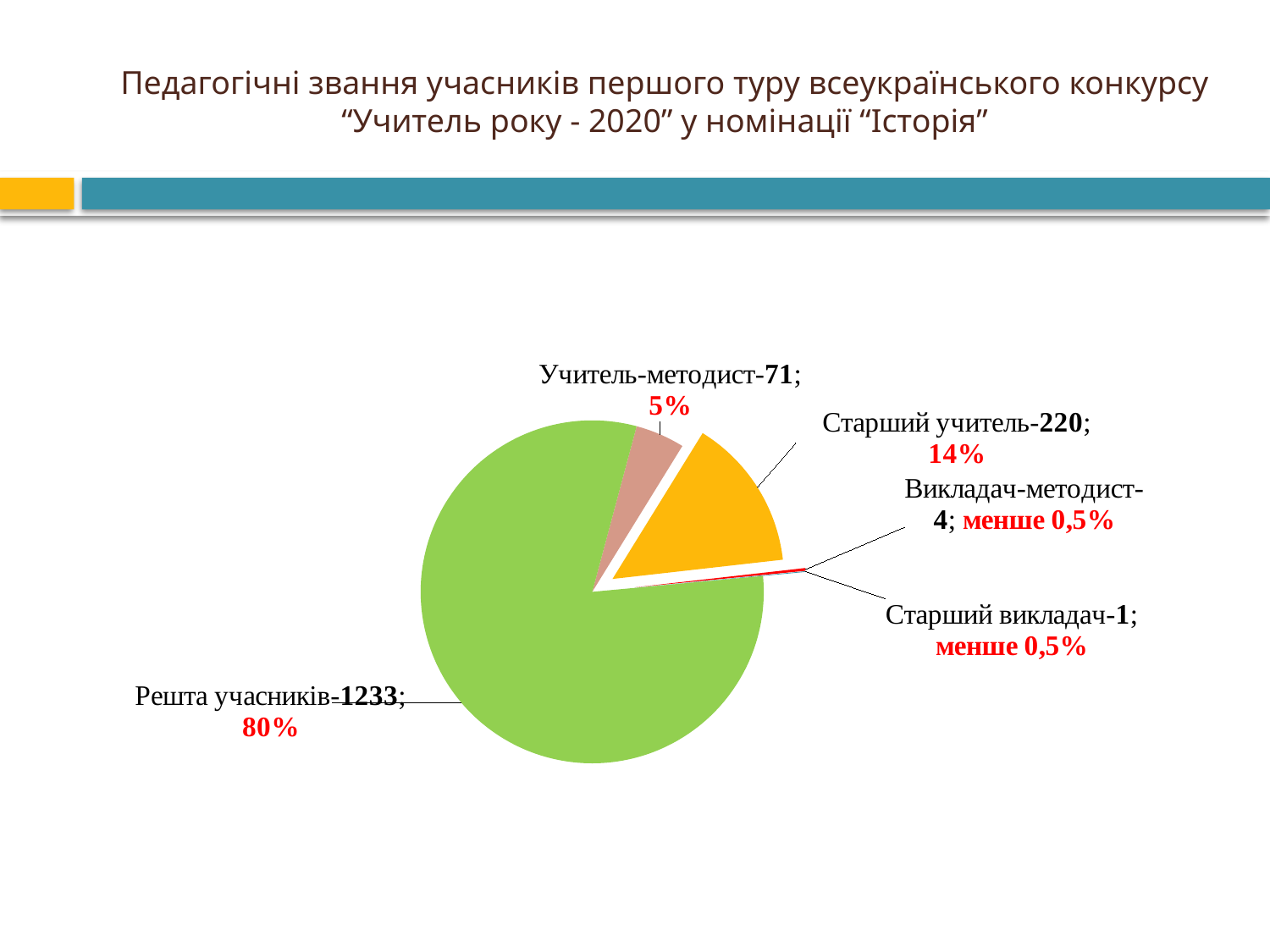
How many categories (slices) does the pie chart show? 5 What share of the pie does Решта учасників represent? 80% Which category has the largest slice of the pie? Решта учасників What is the difference between the number of Старший учитель and Учитель-методист participants? 149 How many participants are labelled as Старший учитель? 220 How many participants are in the Решта учасників category? 1233 What share of the pie does Старший викладач represent? менше 0,5% How many participants are labelled as Учитель-методист? 71 What share of the pie does Старший учитель represent? 14% How many participants are labelled as Викладач-методист? 4 What kind of chart is shown on the slide? Pie chart Which category has the smallest number of participants? Старший викладач